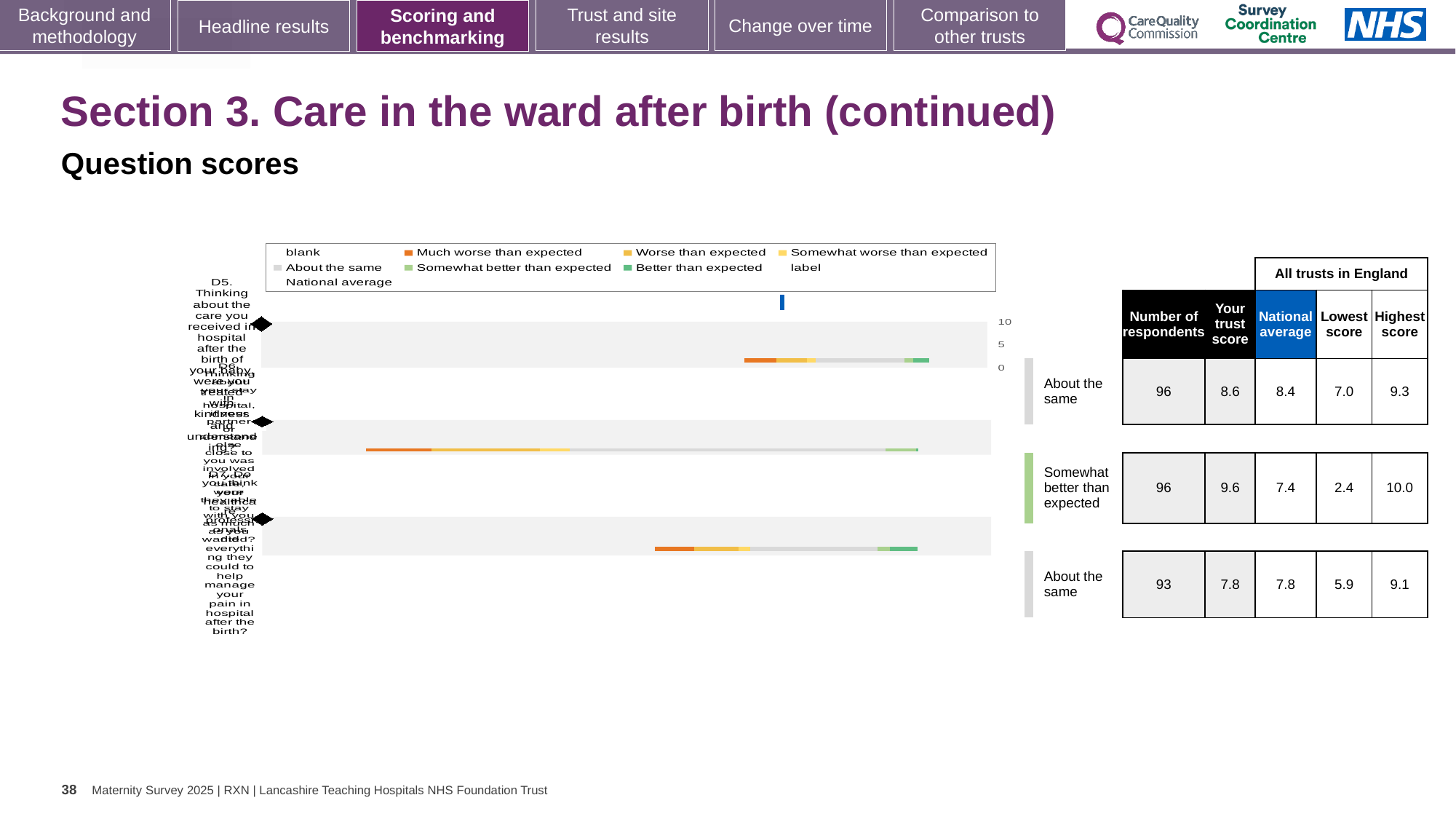
In the table beside the chart, which row has the highest 'Your trust score'? the second row (Somewhat better than expected), 9.6 What is the highest value shown on the chart's axis? 10 In the table beside the chart, what is the difference between the trust score and the national average for the second row (Somewhat better than expected)? 2.2 In the table beside the chart, what is the highest score among all trusts in England for the first row? 9.3 What kind of chart is shown on the slide? bar chart In the table beside the chart, is the trust score or the national average larger for the second row (Somewhat better than expected)? trust score (9.6) What colour does the legend use for 'Much worse than expected'? orange In the table beside the chart, what is the lowest score among all trusts in England for the second row (Somewhat better than expected)? 2.4 What benchmark label is given for the second bar of the chart? Somewhat better than expected In the table beside the chart, how many respondents are listed for the third row? 93 In the table beside the chart, what is the 'Your trust score' for the first row (About the same, 96 respondents)? 8.6 How many bars (question rows) does the chart show? 3